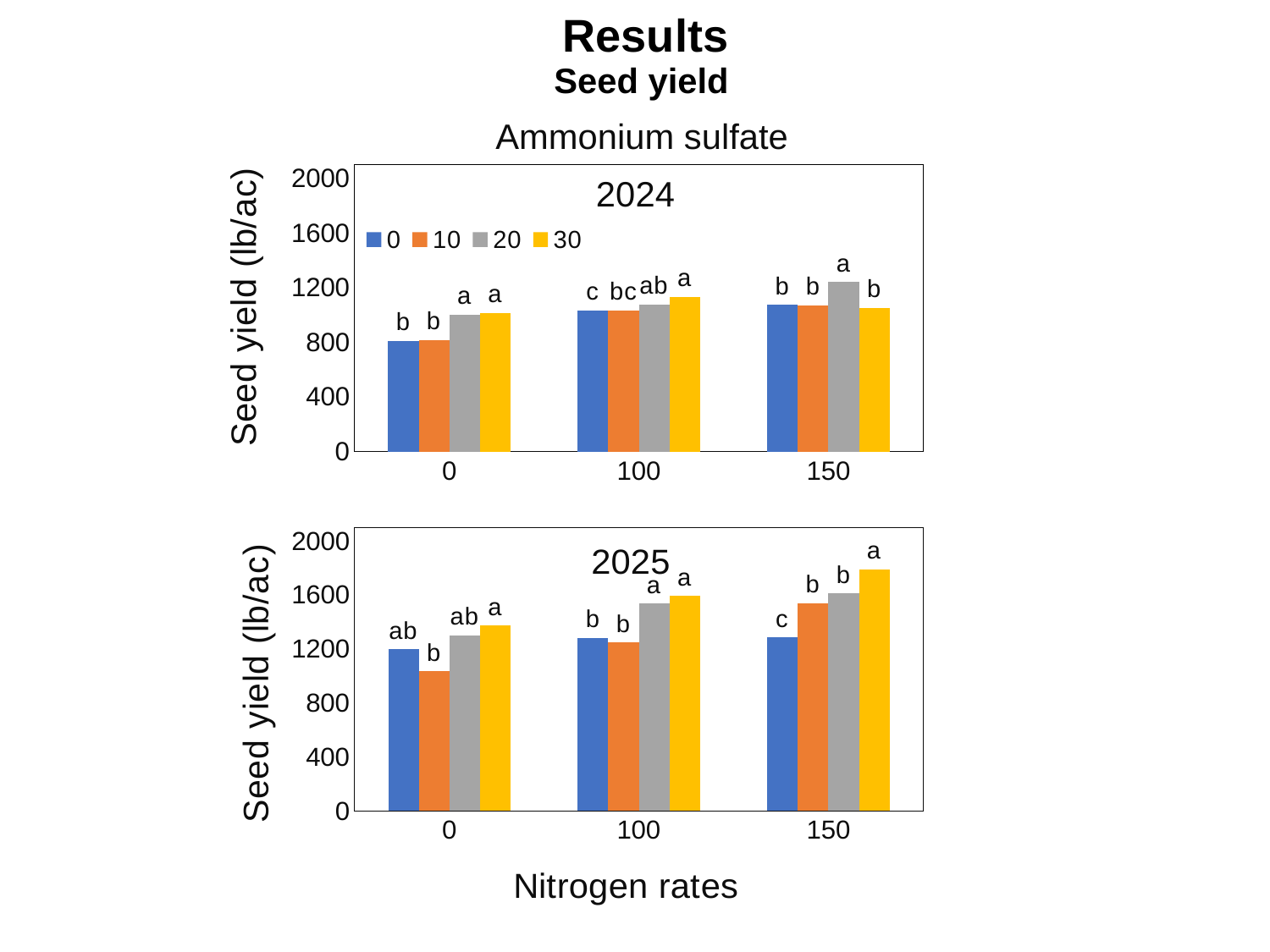
In the 2024 chart, at nitrogen rate 0, which is larger: series 20 or series 0? 20 In the 2024 chart, which series has the highest bar at nitrogen rate 150? 20 What kind of chart is used for the 2024 Ammonium sulfate seed yield data? bar chart In the 2025 chart, how many nitrogen rate categories are shown on the x axis? 3 In the 2025 chart, which series has the highest bar at nitrogen rate 150? 30 In the 2025 chart, is the value for series 10 at nitrogen rate 0 greater or less than 1200? less In the 2024 chart, how many series does the legend list? 4 In the 2025 chart, do the values for series 30 rise or fall as the nitrogen rate increases from 0 to 150? rise In the 2024 chart, is the value for series 0 at nitrogen rate 0 greater or less than 1200? less What is the y-axis label on the 2025 chart? Seed yield (lb/ac) In the 2025 chart, is the value for series 30 at nitrogen rate 150 greater or less than 1600? greater In the 2025 chart, which series has the lowest bar at nitrogen rate 0? 10